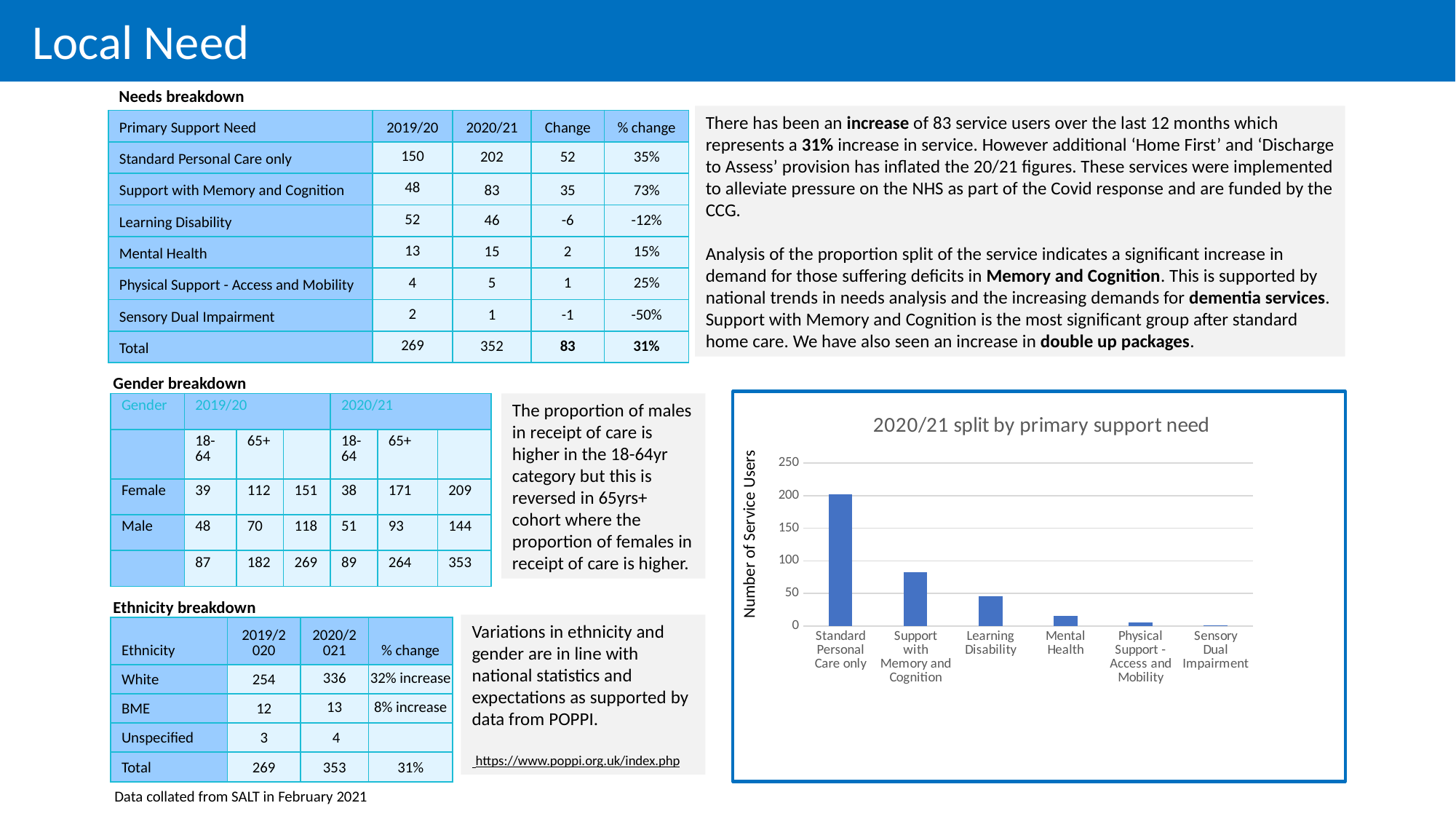
Which category has the lowest value in the chart? Sensory Dual Impairment Is the value for Mental Health greater or less than 50? less Is the value for Learning Disability greater or less than 50? less What is the title of the chart on the slide? 2020/21 split by primary support need What type of chart is shown on the slide? bar chart Which category has the highest value in the chart? Standard Personal Care only Do the values in the chart rise or fall from left to right along the x axis? fall Is the value for Support with Memory and Cognition greater or less than 100? less What is the label of the vertical axis of the chart? Number of Service Users Which is larger in the chart, Learning Disability or Mental Health? Learning Disability How many categories are plotted in the chart? 6